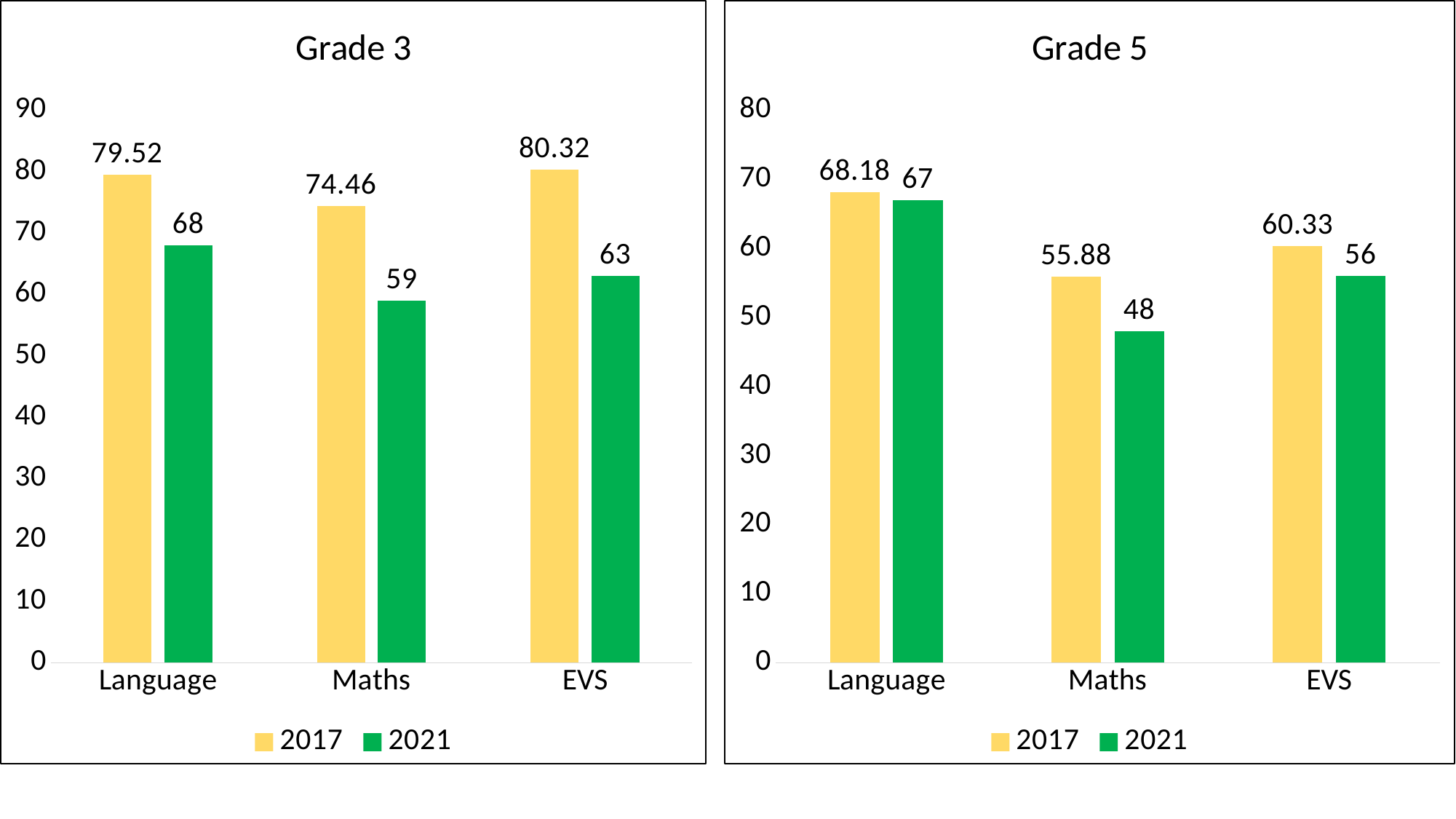
In the Grade 5 chart, what is the difference between the 2017 and 2021 values for Language? 1.18 In the Grade 5 chart, what is the 2017 value for EVS? 60.33 In the Grade 5 chart, what is the 2021 value for Maths? 48 How many subjects are shown on the x axis of the Grade 3 chart? 3 In the Grade 3 chart, what is the 2021 value for Maths? 59 In the Grade 3 chart, what is the difference between the 2017 and 2021 values for EVS? 17.32 In the Grade 3 chart, what is the 2017 value for Language? 79.52 In the Grade 3 chart, which subject has the highest 2017 value? EVS In the Grade 5 chart, which is larger for Maths: the 2017 value or the 2021 value? 2017 In the Grade 5 chart, which subject has the lowest 2021 value? Maths How many series does the legend of the Grade 5 chart list? 2 What kind of chart is the Grade 3 chart? Bar chart